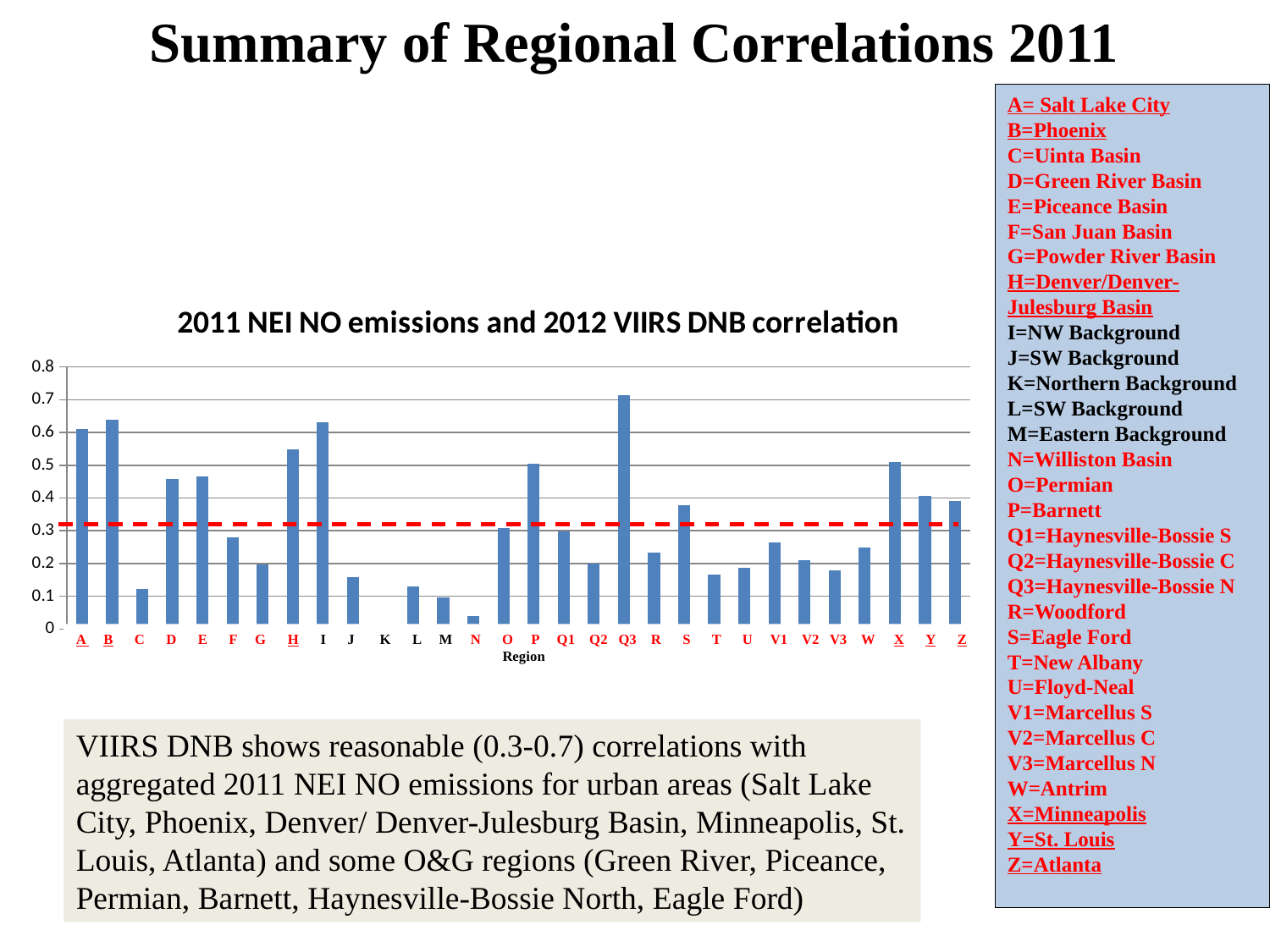
Which region has the highest correlation value in the chart? Q3 Is the value for region H greater or less than 0.5? greater Which has the larger value, region Q3 or region P? Q3 How many region categories are listed along the x axis of the chart? 30 What is the label of the x axis of the chart? Region Is the value for region D greater or less than 0.4? greater Is the value for region A greater or less than 0.5? greater What kind of chart is shown on the slide? bar chart Which has the larger value, region H or region I? I What is the title of the chart? 2011 NEI NO emissions and 2012 VIIRS DNB correlation